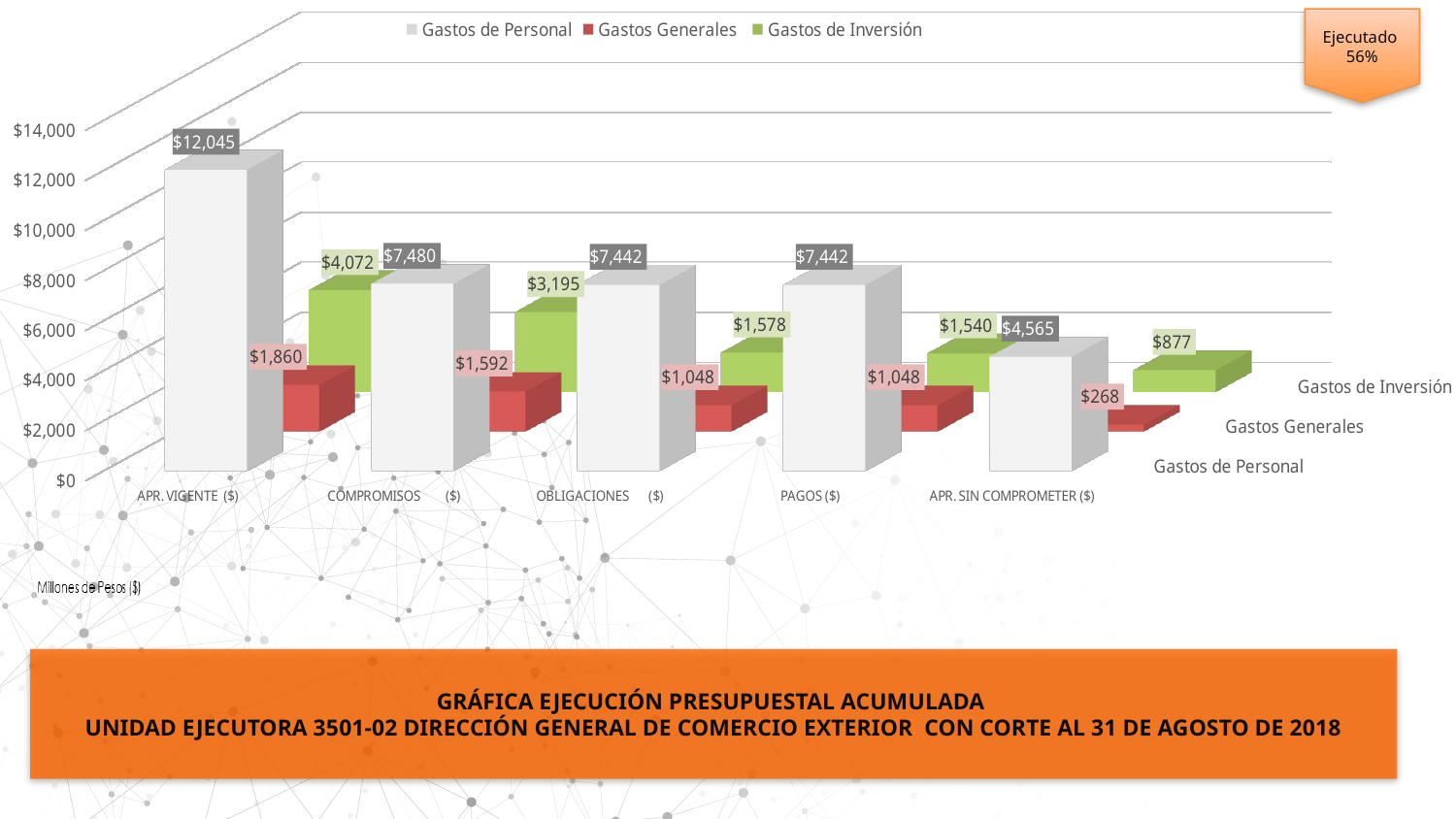
What percentage is shown in the 'Ejecutado' label at the top right of the slide? 56% What kind of chart is shown on the slide? Bar chart What is the value of Gastos de Personal for APR. VIGENTE ($)? $12,045 How many categories are shown on the x axis? 5 Which category has the lowest value for Gastos de Inversión? APR. SIN COMPROMETER ($) Which is larger: Gastos Generales for APR. VIGENTE ($) or Gastos Generales for COMPROMISOS ($)? Gastos Generales for APR. VIGENTE ($) Which category has the highest value for Gastos de Personal? APR. VIGENTE ($) Do the values for Gastos de Inversión rise or fall from APR. VIGENTE ($) to APR. SIN COMPROMETER ($)? Fall What is the value of Gastos de Inversión for COMPROMISOS ($)? $3,195 How many series does the legend list? 3 What is the difference between Gastos de Personal for APR. VIGENTE ($) and for COMPROMISOS ($)? $4,565 What is the value of Gastos Generales for APR. SIN COMPROMETER ($)? $268